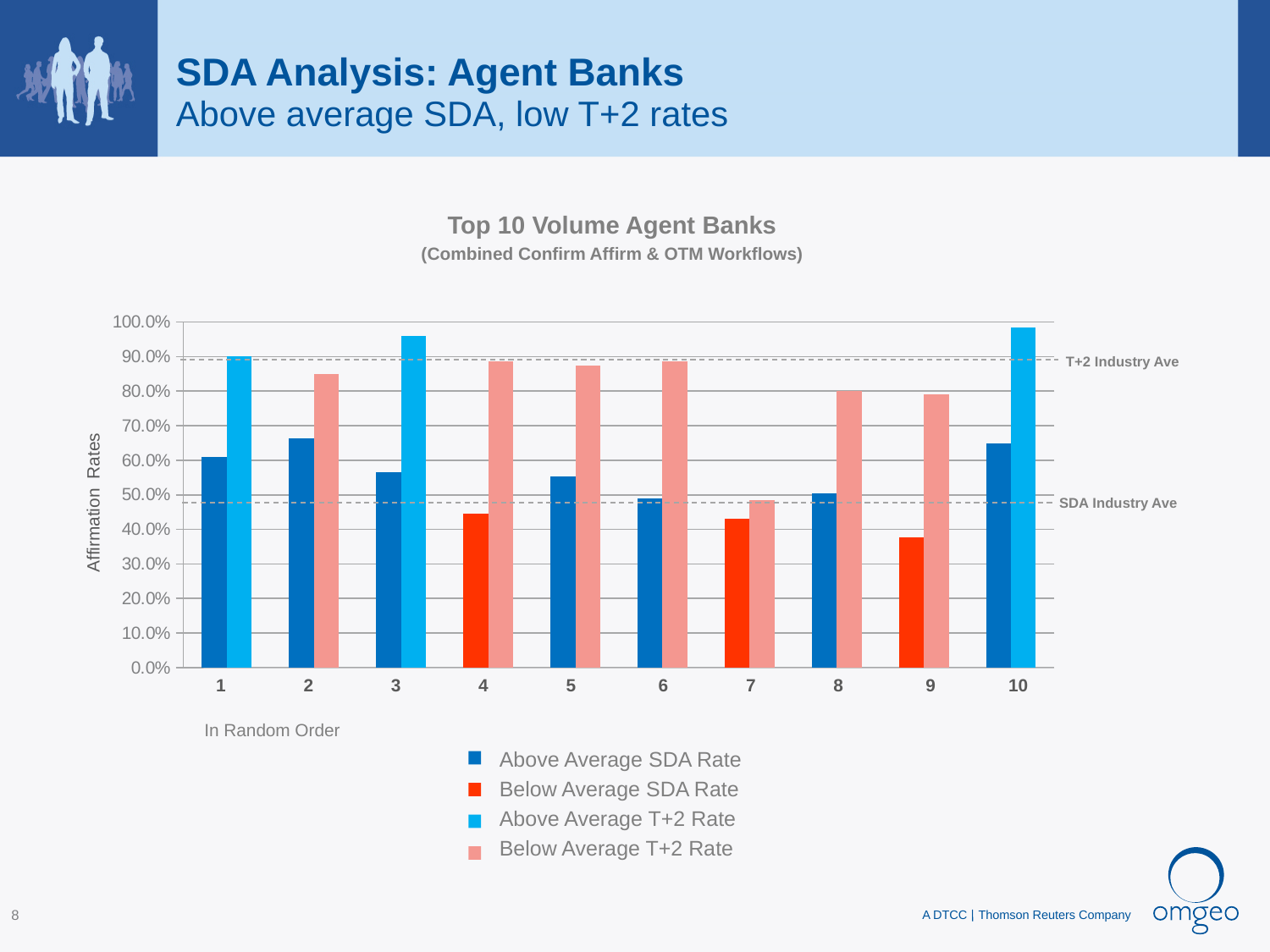
How many series does the chart's legend list? 4 What is the title of the chart? Top 10 Volume Agent Banks Which agent bank has the lowest T+2 rate? 7 What kind of chart is shown on the slide? Bar chart Is the SDA rate for agent bank 4 greater or less than 50.0%? less How many agent banks are shown on the x axis of the chart? 10 Which agent bank has the lowest SDA rate? 9 What are the two dashed horizontal reference lines on the chart labelled? T+2 Industry Ave and SDA Industry Ave Which is larger, the T+2 rate for agent bank 1 or the T+2 rate for agent bank 2? Agent bank 1 Is the SDA rate for agent bank 2 greater or less than 60.0%? greater Is the T+2 rate for agent bank 3 greater or less than 90.0%? greater